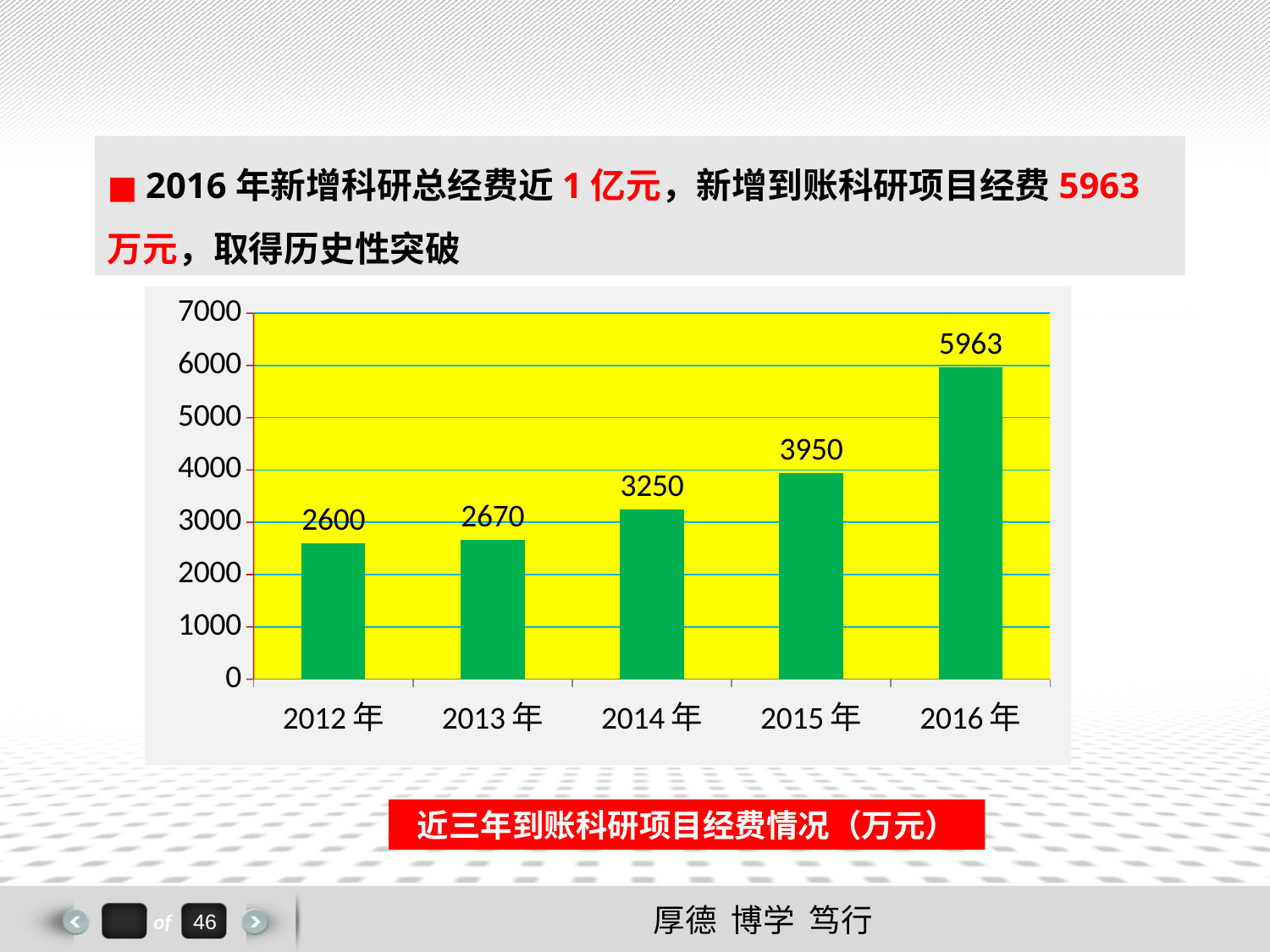
What kind of chart is shown on the slide? bar chart What is the value for 2014年? 3250 What is the value for 2016年? 5963 Which is larger, the value for 2014年 or the value for 2015年? 2015年 Which year has the lowest value? 2012年 What is the value for 2012年? 2600 Is the value for 2015年 greater or less than 4000? less Do the values rise or fall from 2012年 to 2016年? rise How many years are shown on the x axis? 5 What is the difference between the values for 2013年 and 2012年? 70 Which year has the highest value? 2016年 What is the difference between the values for 2016年 and 2015年? 2013